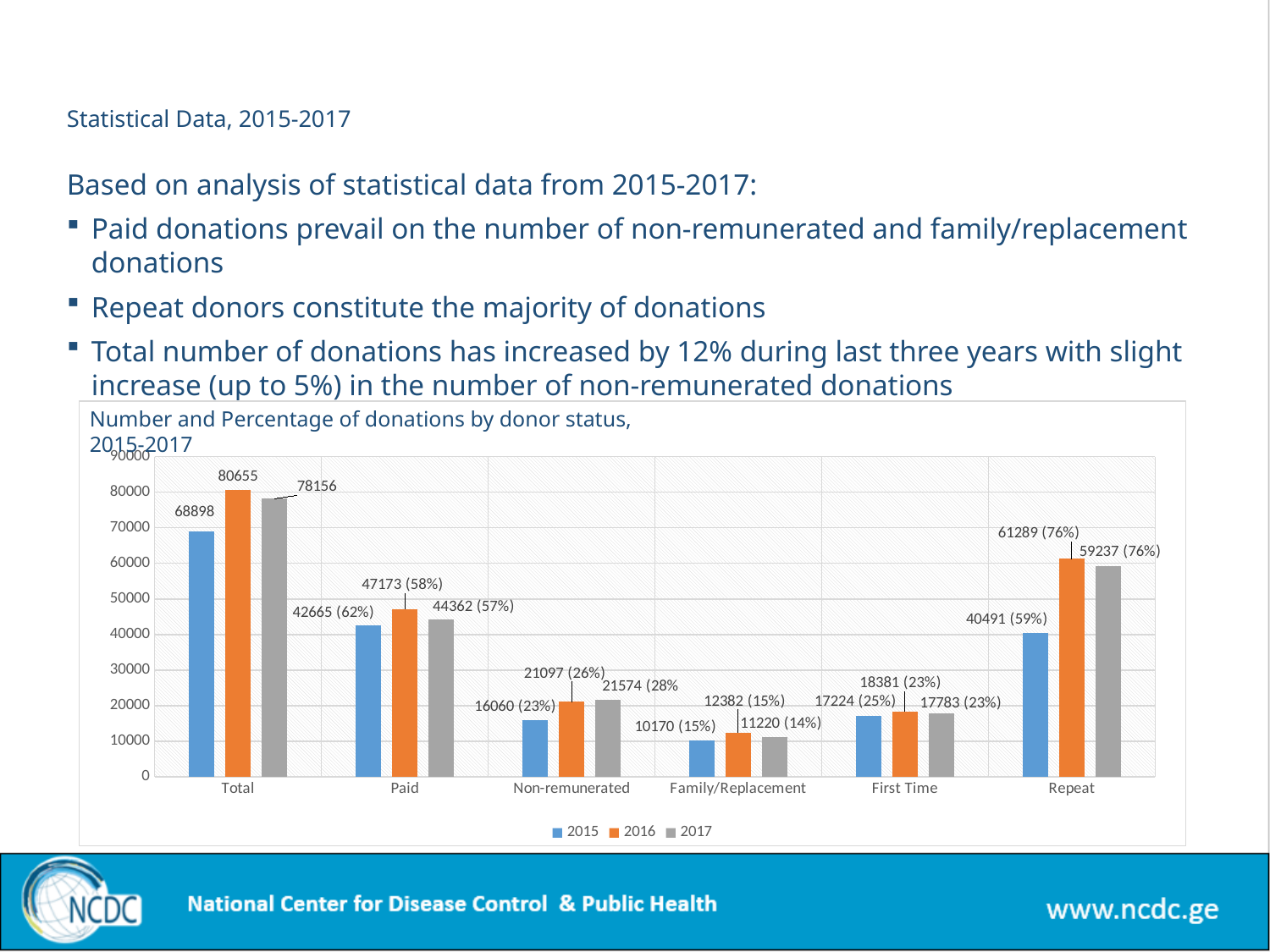
Is the 2015 value for Non-remunerated greater or less than 20000? less What data label is shown on the 2017 bar for Repeat? 59237 (76%) What is the difference between the 2016 and 2015 Total values? 11757 Which category has the lowest 2015 value? Family/Replacement Which is larger, the 2017 value for Paid or the 2017 value for Repeat? Repeat How many categories are shown on the x axis? 6 What data label is shown on the 2016 bar for Family/Replacement? 12382 (15%) Which year has the highest Total value? 2016 What is the value of the 2016 bar for Total? 80655 What data label is shown on the 2015 bar for Paid? 42665 (62%) What type of chart is shown on the slide? bar chart How many series does the legend list? 3